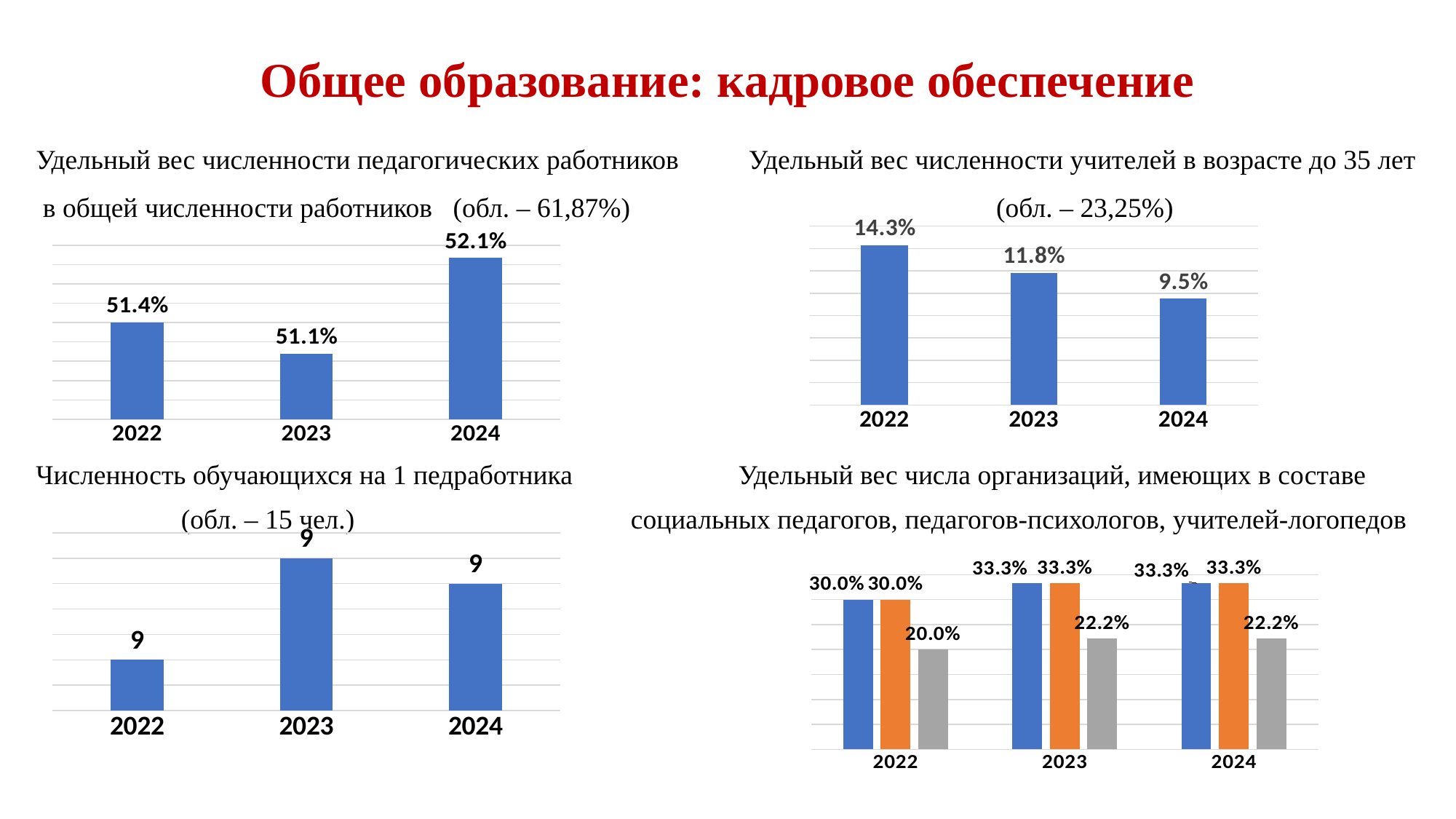
In the top-right chart (share of teachers under 35), do the values rise or fall from 2022 to 2024? fall In the top-right chart (share of teachers under 35), which is larger, the value for 2023 or 2024? 2023 In the top-right chart (share of teachers under 35), what is the difference between the 2022 and 2024 values? 4.8% In the bottom-right chart (share of organisations with social pedagogues, psychologists, speech therapists), what is the value of the grey bar for 2023? 22.2% In the top-left chart (share of pedagogical workers in total workforce), what is the difference between the 2024 and 2023 values? 1.0% What type of chart is the top-left chart (share of pedagogical workers in total workforce)? bar chart In the bottom-right chart (share of organisations with social pedagogues, psychologists, speech therapists), how many bars are shown for each year? 3 In the top-left chart (share of pedagogical workers in total workforce), which year has the lowest value? 2023 In the top-left chart (share of pedagogical workers in total workforce), what is the value for 2024? 52.1% In the top-right chart (share of teachers under 35), what is the value for 2022? 14.3% How many years are shown on the x axis of the bottom-left chart (number of students per pedagogical worker)? 3 In the bottom-left chart (number of students per pedagogical worker), what is the value for 2023? 9